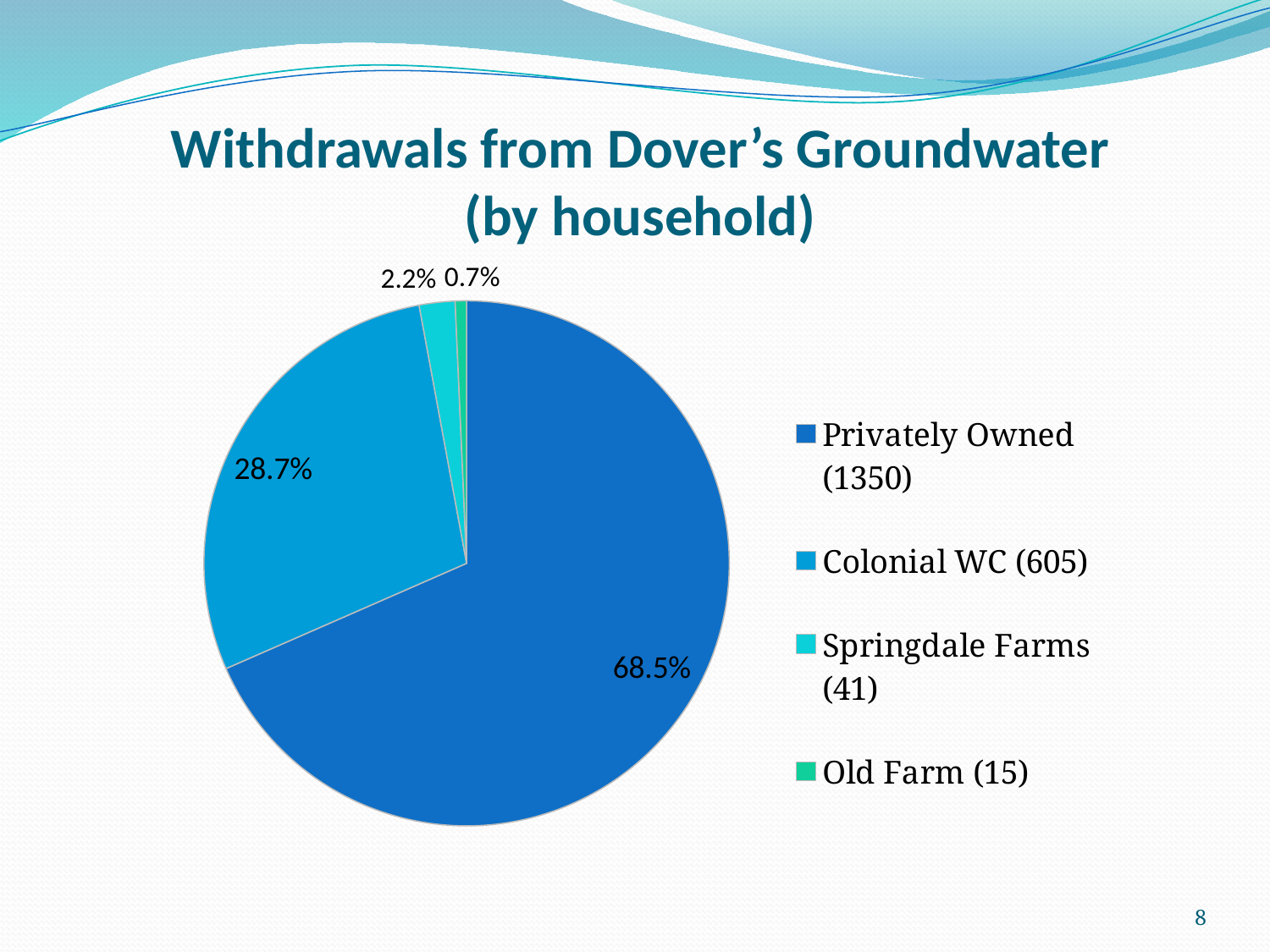
What kind of chart is shown on the slide? pie chart What percentage share does Old Farm have? 0.7% Which category has the smallest slice of the pie? Old Farm Which category has the largest slice of the pie? Privately Owned What percentage share does Colonial WC have? 28.7% What percentage share does Springdale Farms have? 2.2% What household count is shown in the legend for Colonial WC? 605 What is the difference in percentage points between the Privately Owned and Colonial WC shares? 39.8 How many categories does the legend list? 4 Which has a larger share, Colonial WC or Springdale Farms? Colonial WC What is the title of the chart? Withdrawals from Dover's Groundwater (by household)